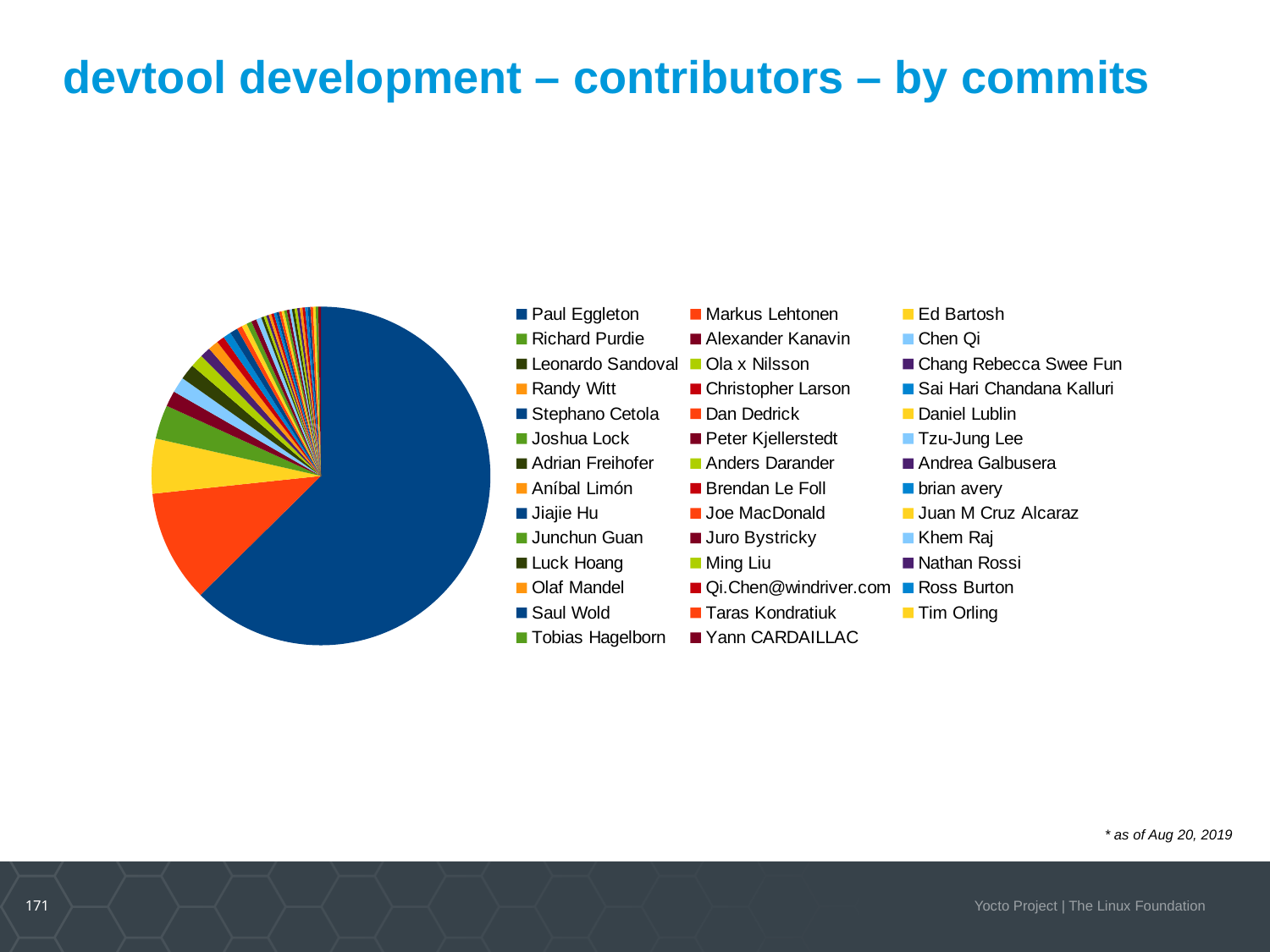
What is the title of the slide containing the chart? devtool development – contributors – by commits Which slice is larger, Paul Eggleton's or Richard Purdie's? Paul Eggleton How many contributors are listed in the chart's legend? 41 Which contributor has the largest slice of the pie? Paul Eggleton Does Paul Eggleton's slice account for more or less than half of the pie? more Which slice is larger, Richard Purdie's or Leonardo Sandoval's? Richard Purdie Which contributor is listed first in the legend? Paul Eggleton What kind of chart is shown on the slide? pie chart